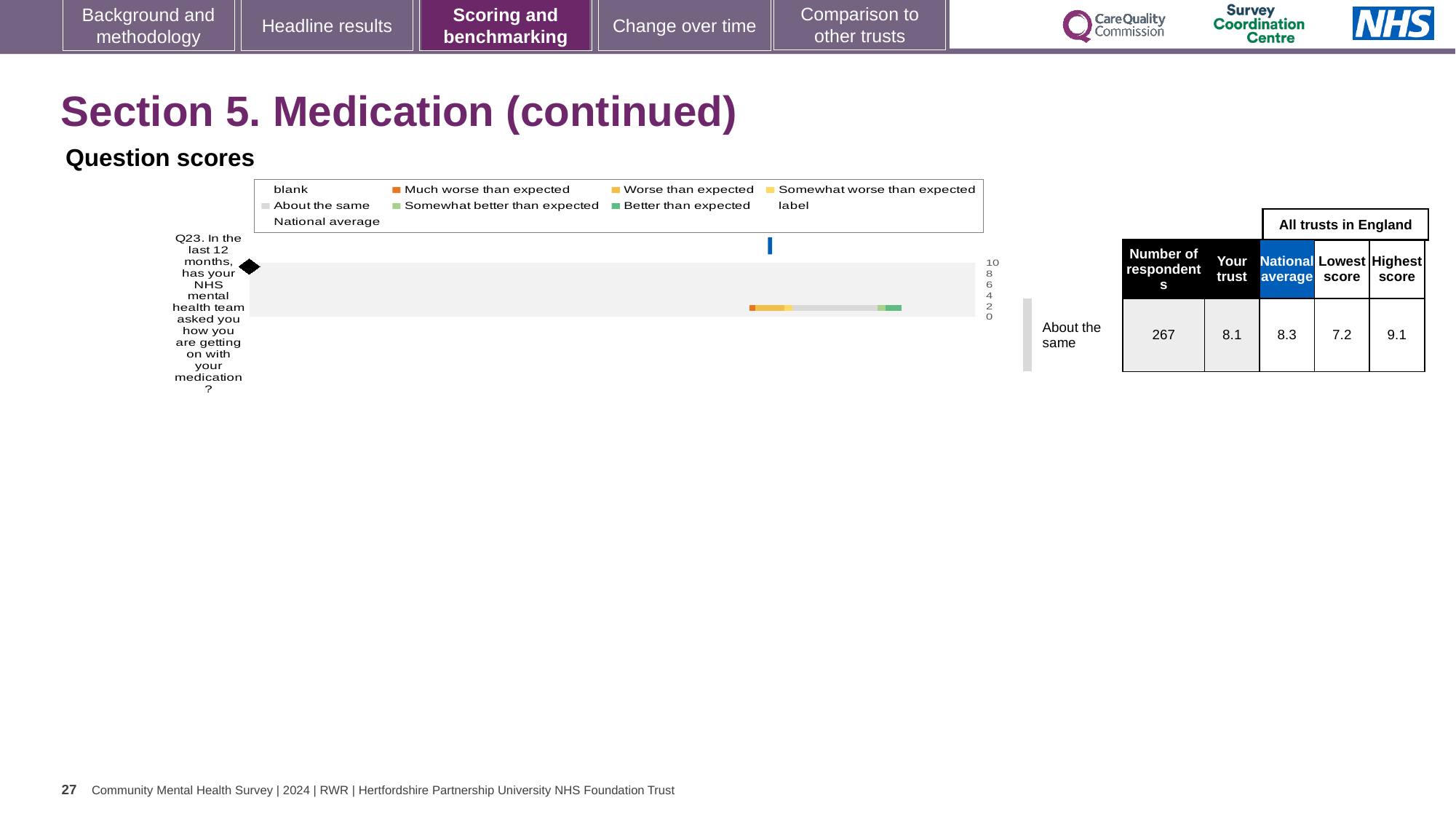
What is the difference between the Highest score and the Lowest score for Q23? 1.9 How many respondents answered Q23? 267 What is the National average score for Q23 shown next to the chart? 8.3 Which is larger for Q23, the 'Your trust' score or the National average? National average What is the difference between the National average and the 'Your trust' score for Q23? 0.2 What is the 'Your trust' score for Q23 shown next to the chart? 8.1 What kind of chart is used to show the question score for Q23? bar chart What is the Lowest score among all trusts in England for Q23? 7.2 How many questions are plotted in the Question scores chart? 1 Which benchmarking category is the trust's Q23 score placed in? About the same Which question is shown in the Question scores chart? Q23. In the last 12 months, has your NHS mental health team asked you how you are getting on with your medication? What is the Highest score among all trusts in England for Q23? 9.1